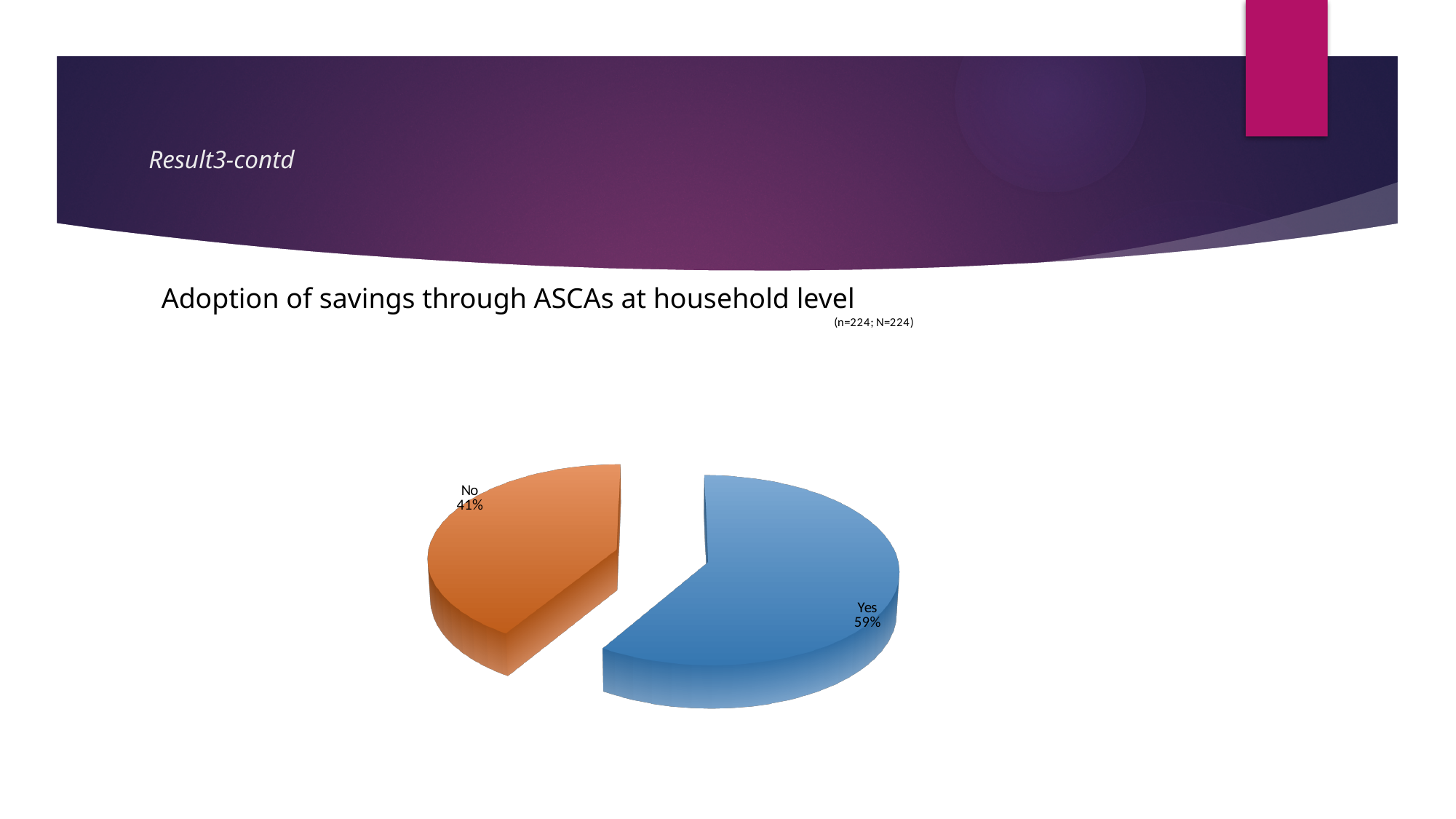
What share of the pie does the "No" slice represent? 41% Is the value for "Yes" greater or less than 50%? greater What share of the pie does the "Yes" slice represent? 59% How many slices does the pie chart have? 2 What colour is the "No" slice? Orange What is the difference in percentage points between the "Yes" and "No" slices? 18 Which is larger, the "Yes" slice or the "No" slice? Yes What kind of chart is shown on the slide? Pie chart Which slice is the largest in the pie chart? Yes Which slice is the smallest in the pie chart? No